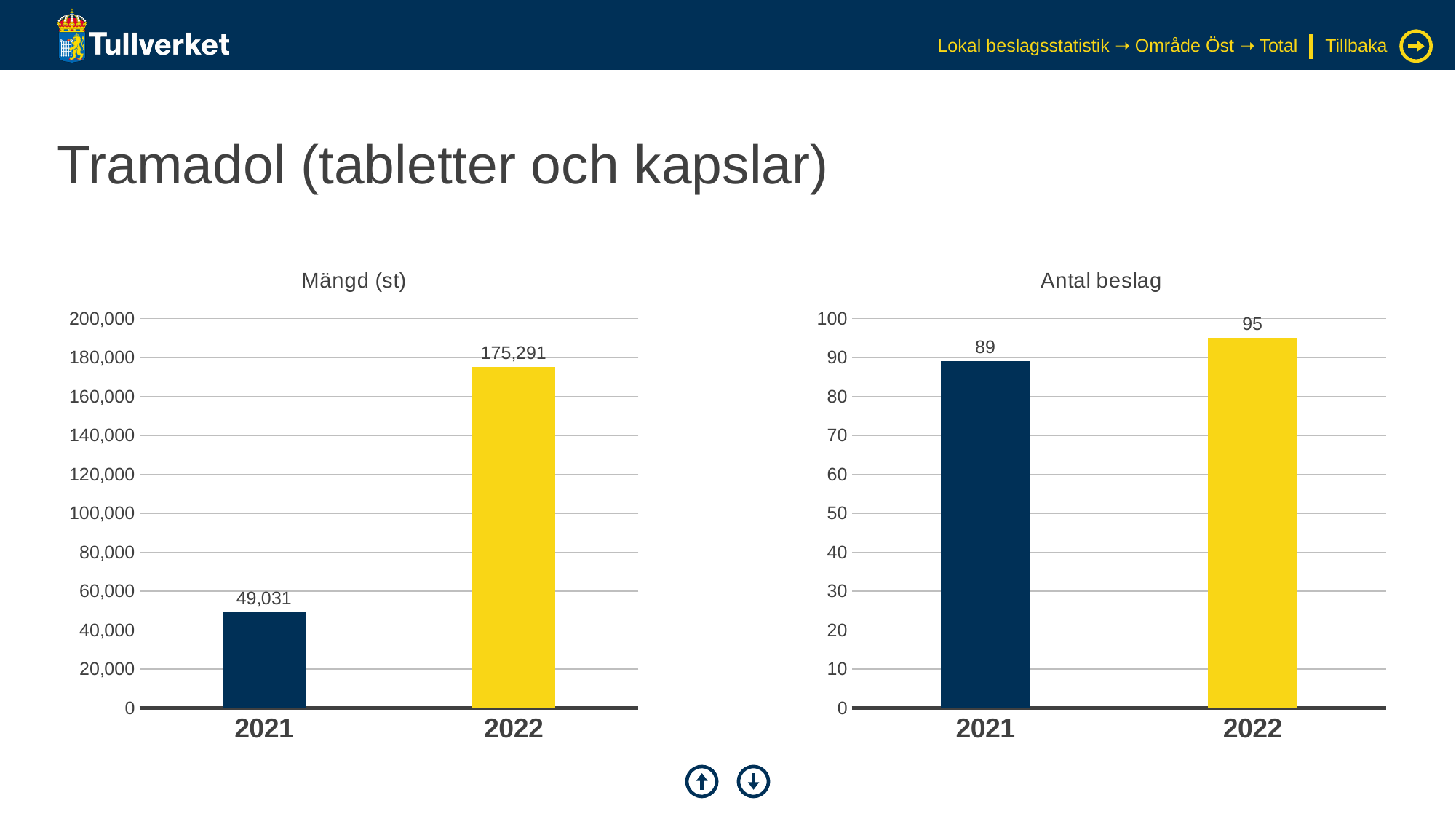
What kind of chart is the 'Mängd (st)' chart? bar chart In the 'Mängd (st)' chart, what is the value for 2021? 49,031 In the 'Mängd (st)' chart, what is the difference between the 2022 and 2021 values? 126,260 In the 'Mängd (st)' chart, which year has the highest value? 2022 How many categories are shown on the x axis of the 'Antal beslag' chart? 2 In the 'Antal beslag' chart, what is the value for 2021? 89 In the 'Antal beslag' chart, which year has the lowest value? 2021 In the 'Antal beslag' chart, what is the difference between the 2022 and 2021 values? 6 In the 'Mängd (st)' chart, is the value for 2021 greater or less than 60,000? less In the 'Antal beslag' chart, what is the value for 2022? 95 In the 'Antal beslag' chart, do the values rise or fall from 2021 to 2022? rise In the 'Mängd (st)' chart, what is the value for 2022? 175,291